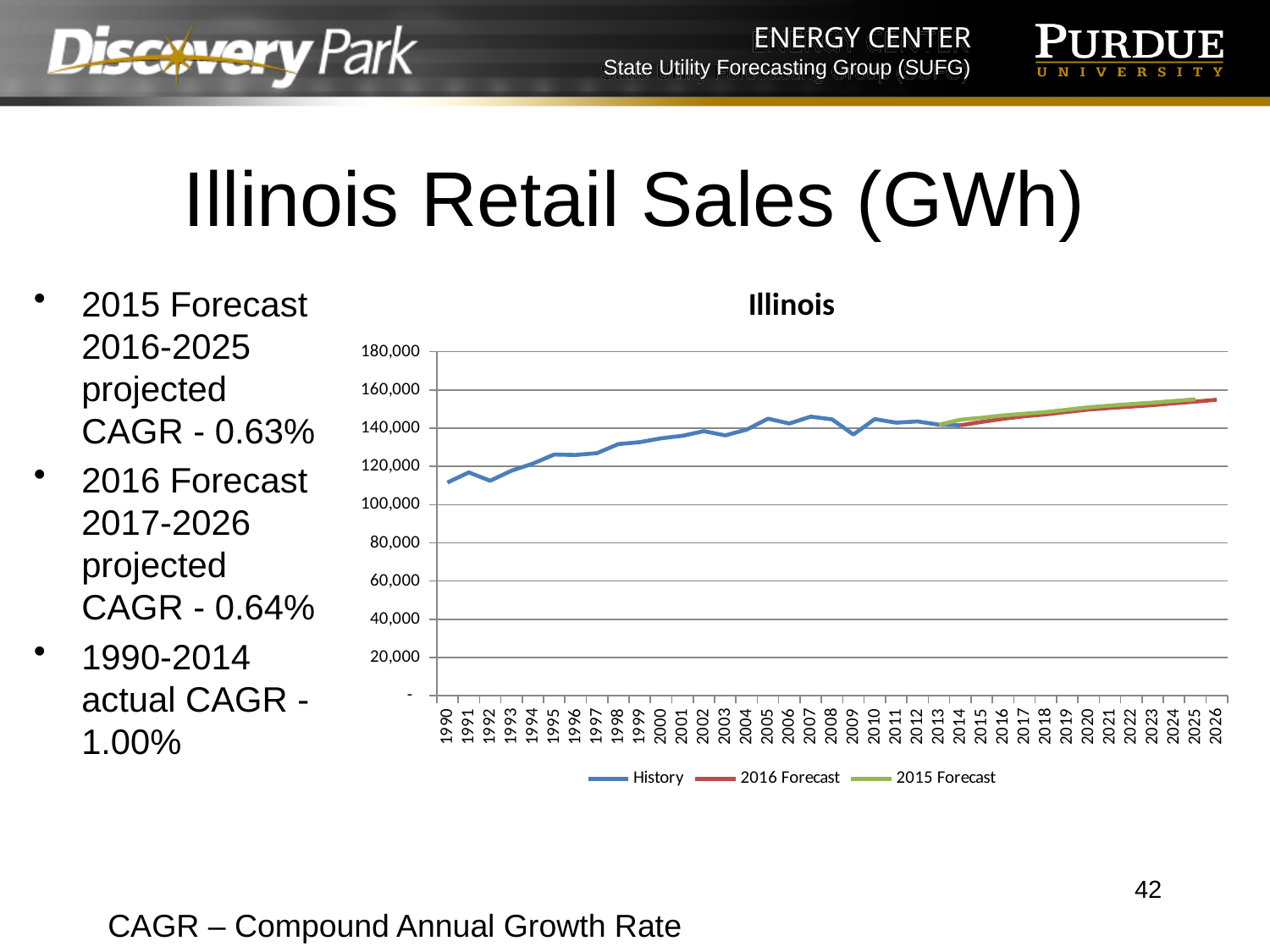
Is the History value for 1992 greater or less than 120,000? less How many series does the legend of the chart list? 3 Is the 2015 Forecast value for 2025 greater or less than 160,000? less What is the title of the chart? Illinois Which is larger, the value for 2026 or the value for 1990? 2026 Is the History value for 2000 greater or less than 120,000? greater What kind of chart is shown on the slide? line chart Overall, do the values in the chart rise or fall from 1990 to 2026? rise What are the three series named in the chart legend? History, 2016 Forecast, 2015 Forecast How many years are labelled on the x axis of the chart? 37